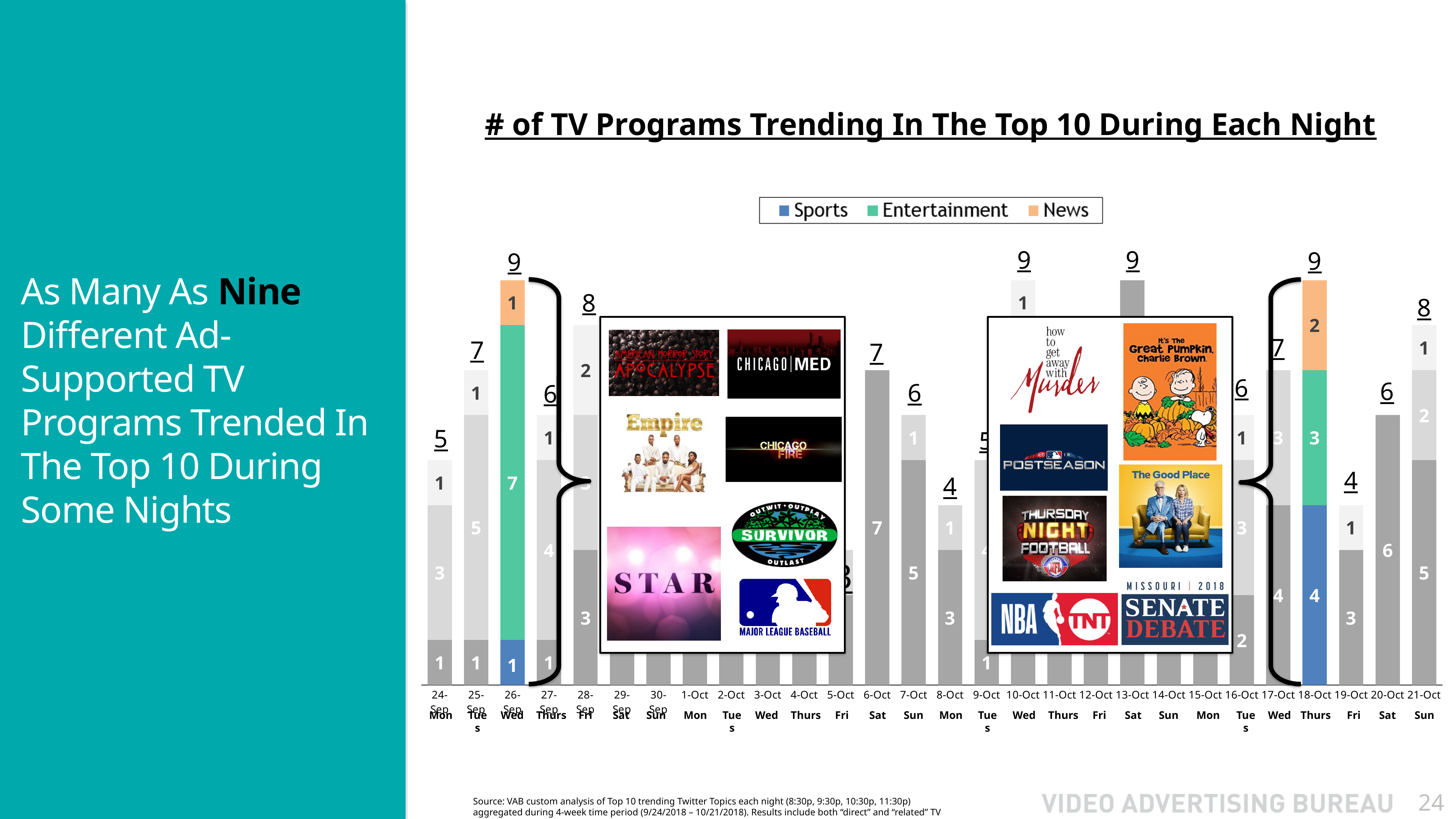
What is the total number of programs trending on 19-Oct (Fri)? 4 What is the difference between the total for 26-Sep and the total for 24-Sep? 4 What is the highest total number of programs trending on any single night shown? 9 How many News programs trended on 18-Oct (Thurs)? 2 How many Sports programs trended on 18-Oct (Thurs)? 4 What is the total number of TV programs trending on 26-Sep (Wed)? 9 How many Entertainment programs trended on 26-Sep (Wed)? 7 What kind of chart is shown on the slide? Stacked bar chart What are the three series listed in the legend? Sports, Entertainment, News What is the total number of programs trending on 21-Oct (Sun)? 8 Which night had more programs trending, 19-Oct or 20-Oct? 20-Oct How many series does the legend list? 3